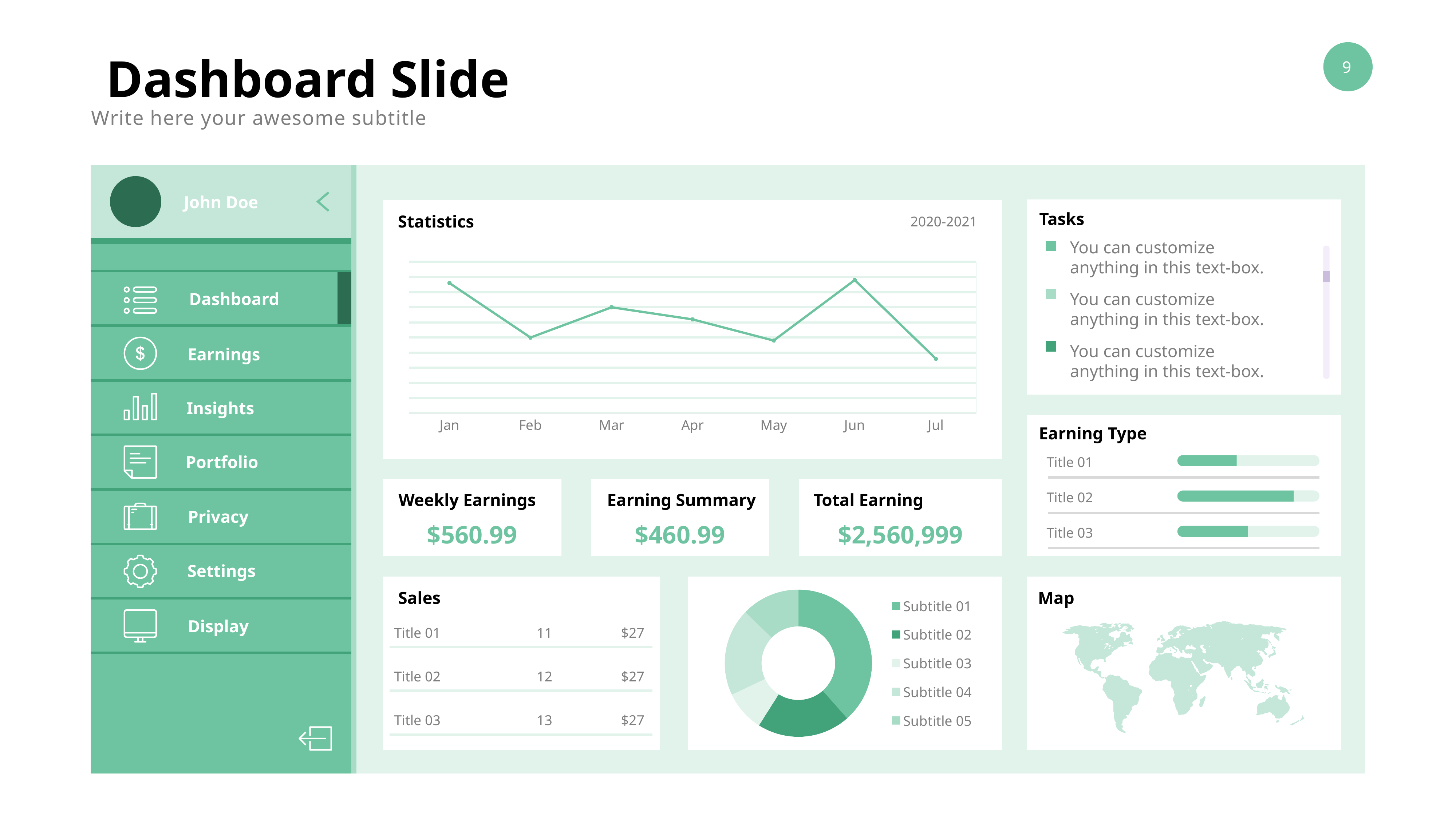
What period label is shown in the top right of the Statistics chart? 2020-2021 How many entries does the legend of the doughnut chart list? 5 What kind of chart is the chart with the Subtitle 01 to Subtitle 05 legend? doughnut chart In the Statistics chart, does the line rise or fall from May to Jun? rise In the Statistics chart, which is higher, Mar or Apr? Mar In the doughnut chart, which legend entry has the largest slice? Subtitle 01 What kind of chart is the Statistics chart? line chart How many months are plotted on the x axis of the Statistics chart? 7 In the Statistics chart, which month has the highest value? Jun In the Statistics chart, is the value for Jan higher or lower than the value for Feb? higher In the Statistics chart, does the line rise or fall from Jan to Feb? fall In the Statistics chart, which month has the lowest value? Jul